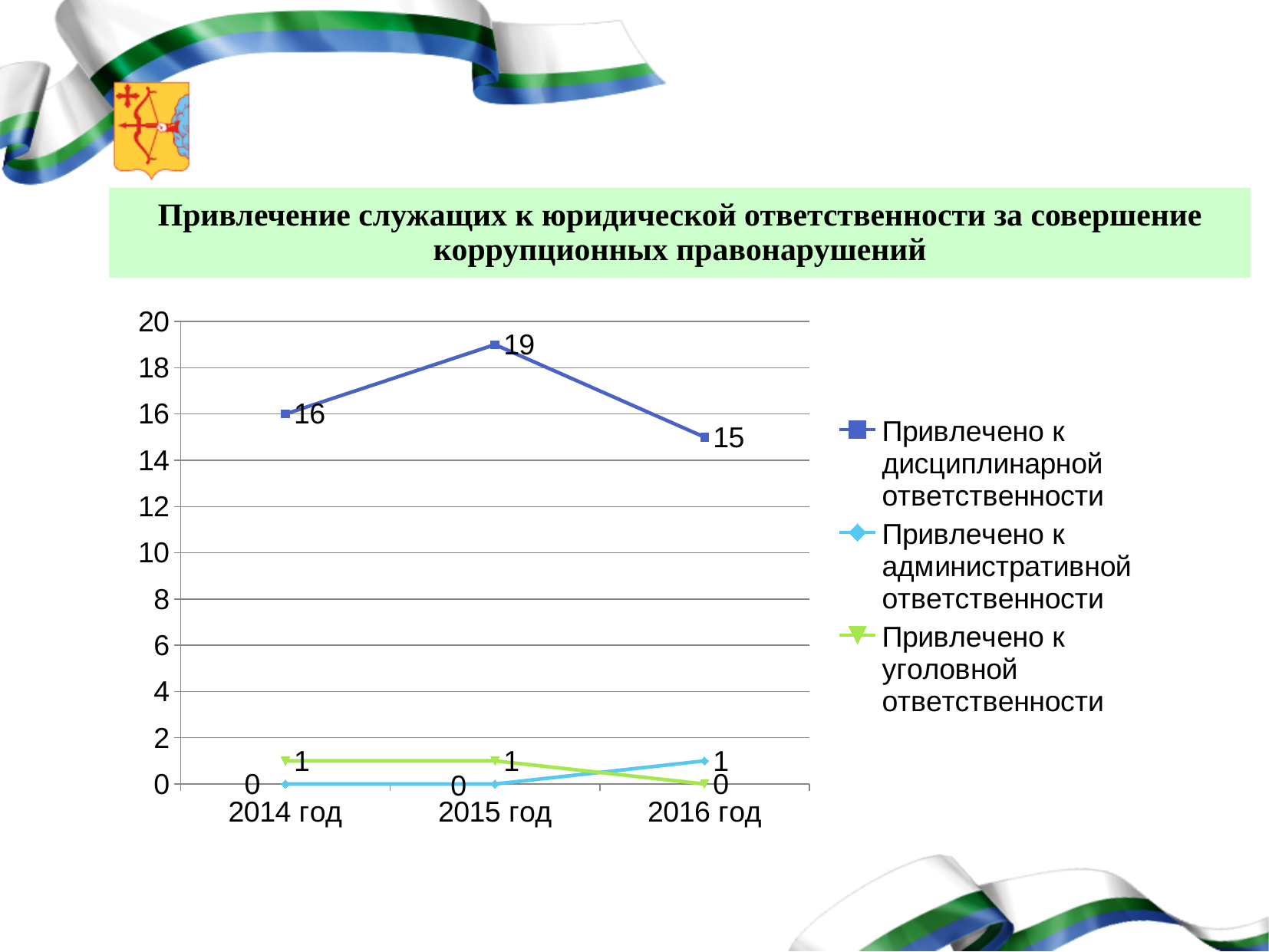
What is the difference between the "Привлечено к дисциплинарной ответственности" values for 2015 год and 2014 год? 3 Which is larger: the "Привлечено к дисциплинарной ответственности" value for 2014 год or for 2016 год? 2014 год In which year is the value for "Привлечено к дисциплинарной ответственности" lowest? 2016 год What is the value for "Привлечено к дисциплинарной ответственности" in 2015 год? 19 What is the value for "Привлечено к дисциплинарной ответственности" in 2016 год? 15 What kind of chart is shown on the slide? line chart What is the value for "Привлечено к административной ответственности" in 2016 год? 1 How many series does the legend list? 3 In which year is the value for "Привлечено к дисциплинарной ответственности" highest? 2015 год What is the value for "Привлечено к уголовной ответственности" in 2014 год? 1 Does the value for "Привлечено к дисциплинарной ответственности" rise or fall from 2015 год to 2016 год? fall How many years are shown on the x axis? 3